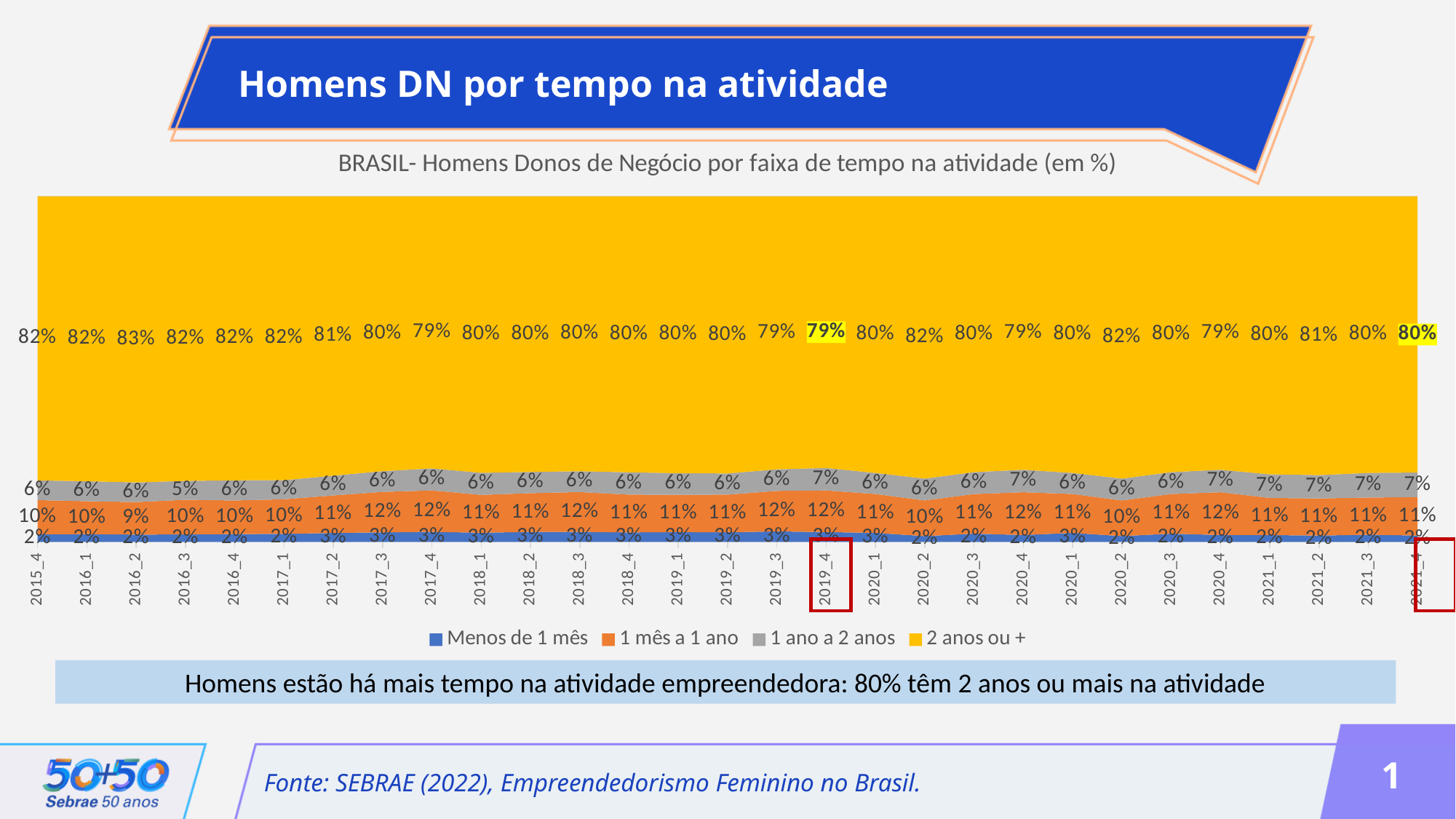
What is the title of the chart? BRASIL- Homens Donos de Negócio por faixa de tempo na atividade (em %) Which period has a larger '2 anos ou +' value, 2016_2 or 2017_4? 2016_2 What is the value of '2 anos ou +' for 2021_4? 80% What is the value of '1 ano a 2 anos' for 2016_3? 5% What is the value of '2 anos ou +' for 2019_4? 79% What kind of chart is shown on the slide? Stacked area chart How many series does the legend list? 4 In which period is the '1 mês a 1 ano' share lowest? 2016_2 In which period is the '2 anos ou +' share highest? 2016_2 What is the value of '1 mês a 1 ano' for 2015_4? 10% What is the difference between the '2 anos ou +' values for 2016_2 and 2019_4? 4 percentage points What is the value of 'Menos de 1 mês' for 2017_3? 3%